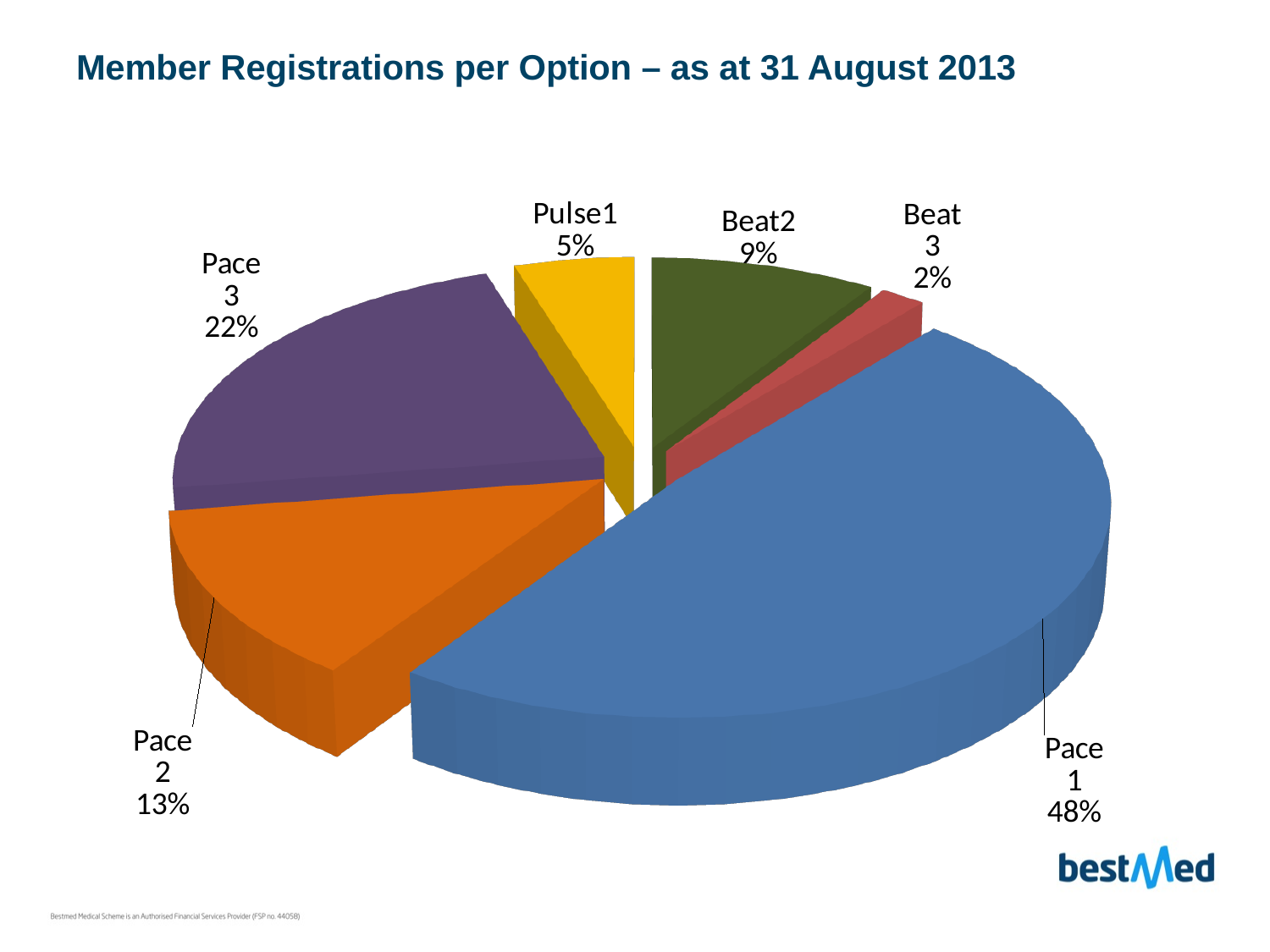
Which option has the largest share of member registrations? Pace 1 What is the title of the chart? Member Registrations per Option – as at 31 August 2013 What share of member registrations does Pace 1 have? 48% What type of chart is shown on the slide? Pie chart What percentage is shown for Pace 3? 22% Which has a larger share, Beat2 or Pulse1? Beat2 What percentage is shown for Beat 3? 2% What percentage is shown for Pulse1? 5% How many options (slices) are shown in the pie chart? 6 What is the difference in percentage points between Pace 2 and Beat2? 4 What is the difference in percentage points between Pace 1 and Pace 3? 26 Which option has the smallest share of member registrations? Beat 3